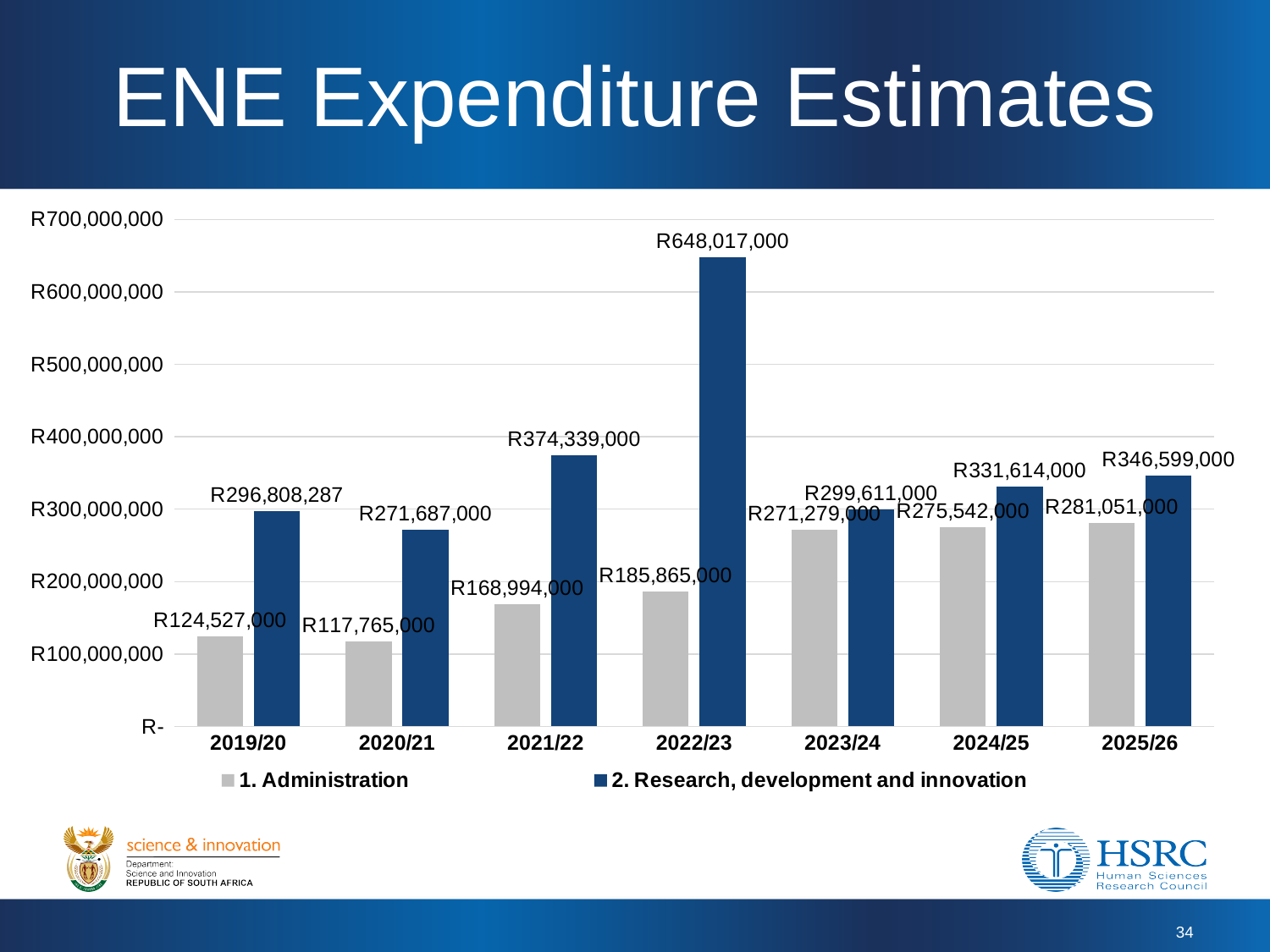
How many series does the legend list? 2 How many financial years are shown on the x axis? 7 What is the difference between 2. Research, development and innovation and 1. Administration in 2022/23? R462,152,000 In which year is the 1. Administration value lowest? 2020/21 Is the value for 2. Research, development and innovation in 2021/22 greater or less than R400,000,000? less In which year is the 2. Research, development and innovation value highest? 2022/23 What is the value for 2. Research, development and innovation in 2019/20? R296,808,287 What kind of chart is shown on the slide? bar chart What is the value for 2. Research, development and innovation in 2022/23? R648,017,000 What is the value for 1. Administration in 2019/20? R124,527,000 By how much does 2. Research, development and innovation increase from 2024/25 to 2025/26? R14,985,000 In 2025/26, which series has the larger value, 1. Administration or 2. Research, development and innovation? 2. Research, development and innovation